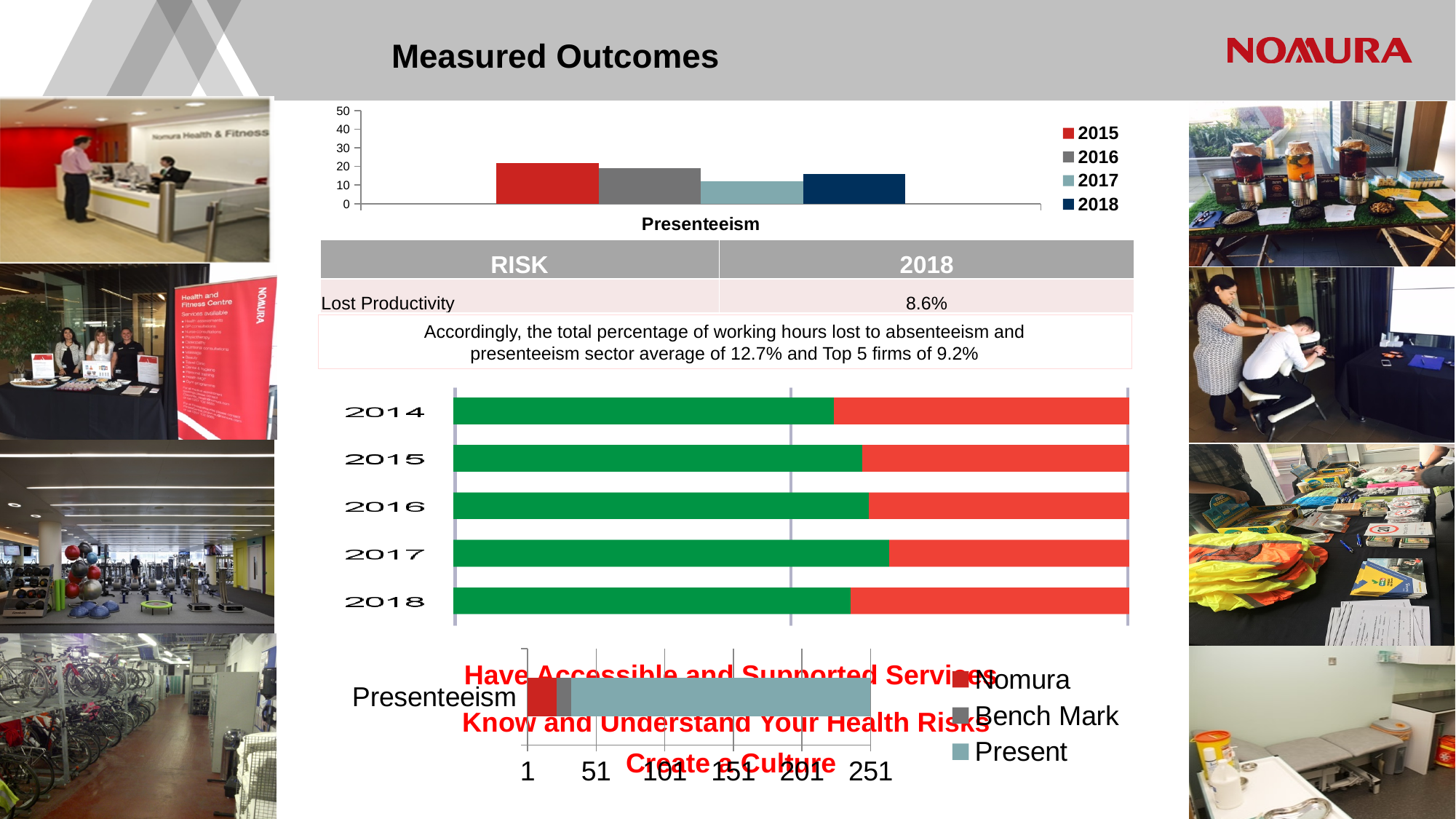
In the top Presenteeism chart, is the value for 2015 greater or less than 10? greater What are the three legend entries of the bottom Presenteeism chart? Nomura, Bench Mark, Present In the middle stacked bar chart, which year has the longest green segment? 2017 In the top Presenteeism chart, which is larger, the bar for 2018 or the bar for 2017? 2018 In the top Presenteeism chart, which year has the highest bar? 2015 In the top Presenteeism chart, is the value for 2017 greater or less than 20? less How many year categories does the middle stacked bar chart show? 5 In the top Presenteeism chart, do the values rise or fall from 2015 to 2017? fall What kind of chart is the top chart titled Presenteeism? bar chart In the top Presenteeism chart, which year has the lowest bar? 2017 How many series does the legend of the top Presenteeism chart list? 4 In the middle stacked bar chart, which year has the shortest green segment? 2014